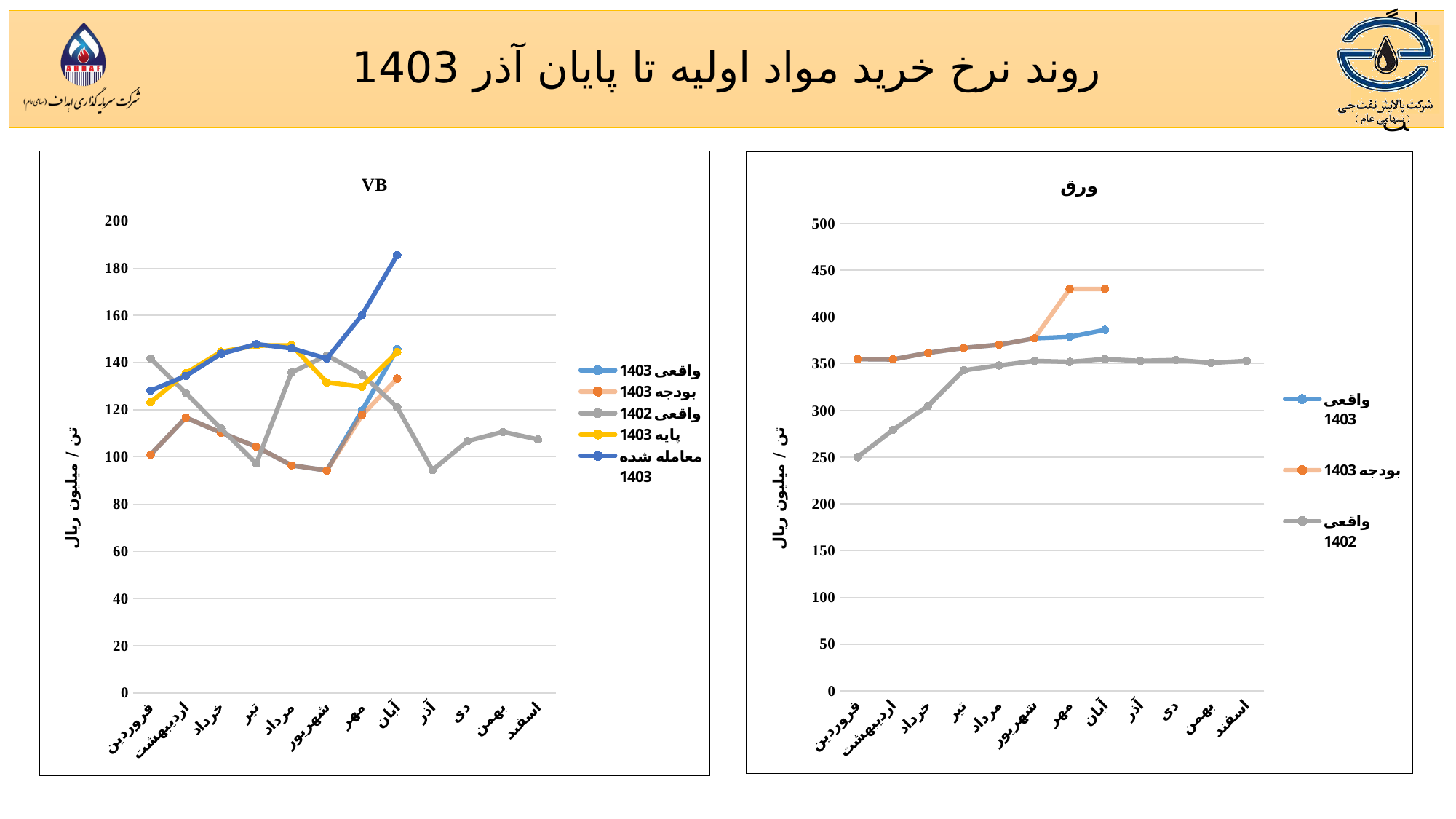
How many series does the legend of the ورق chart list? 3 In the VB chart, is the value of معامله شده 1403 in آبان greater or less than 180? greater In the ورق chart, in which month is واقعی 1402 at its lowest? فروردین In the ورق chart, is the value of واقعی 1402 in فروردین greater or less than 300? less How many months are shown on the x axis of the ورق chart? 12 In the VB chart, is the value of واقعی 1402 in آذر greater or less than 100? less In the ورق chart, which is larger in آبان: بودجه 1403 or واقعی 1403? بودجه 1403 In the VB chart, in which month does معامله شده 1403 reach its highest value? آبان What kind of chart is the VB chart on the left? Line chart How many series does the legend of the VB chart list? 5 In the ورق chart, does the واقعی 1402 line rise or fall from فروردین to تیر? rise